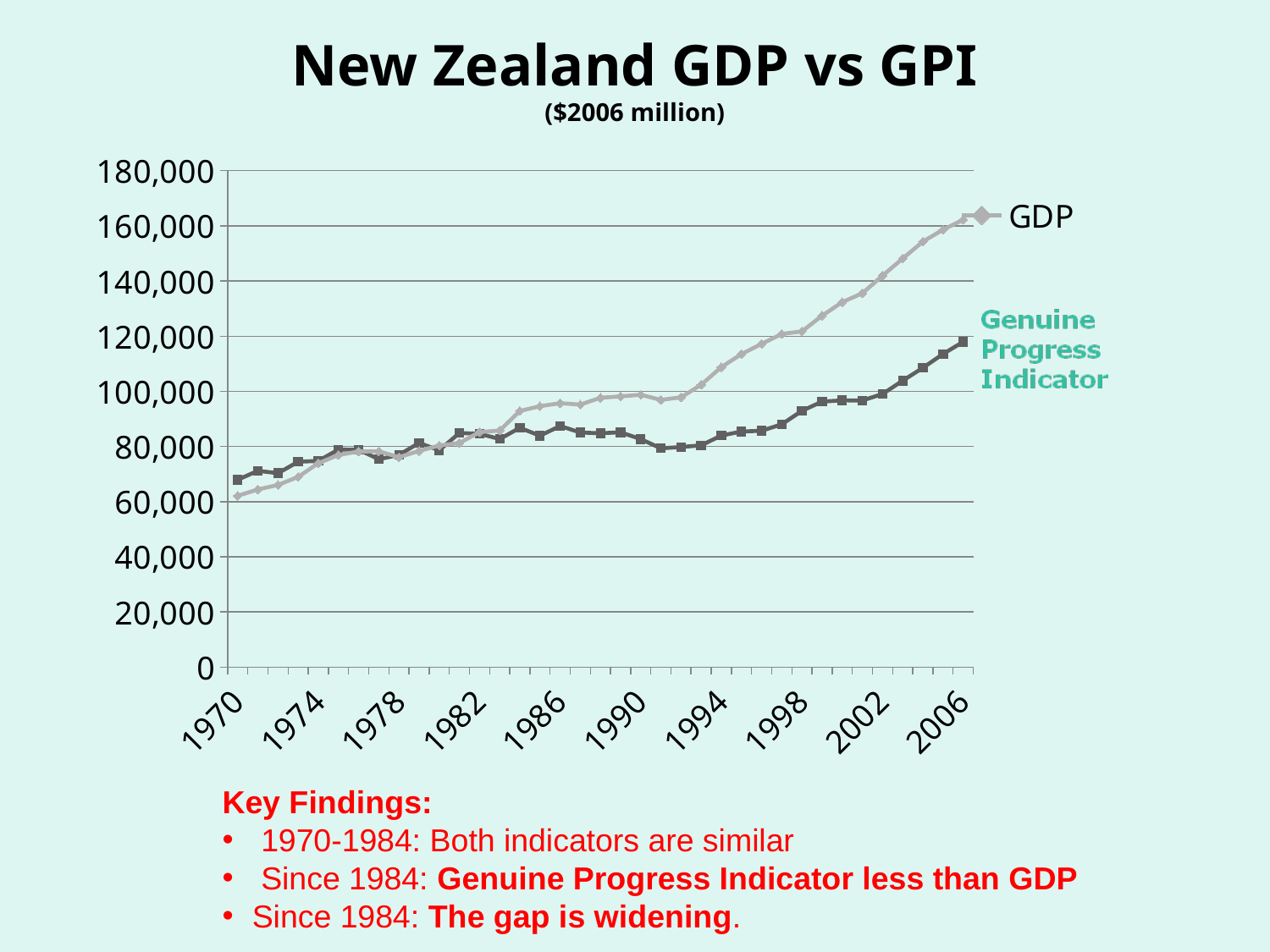
Is the Genuine Progress Indicator value for 2006 greater or less than 100,000? greater What unit is given under the chart title? $2006 million In 2006, which series has the higher value, GDP or Genuine Progress Indicator? GDP How many series are plotted on the chart? 2 Is the Genuine Progress Indicator value for 1994 greater or less than 100,000? less Is the GDP value for 2006 greater or less than 140,000? greater What is the title of the chart? New Zealand GDP vs GPI What kind of chart is shown on the slide? line chart Does the GDP series rise or fall overall from 1970 to 2006? rise In 1970, which series has the higher value, GDP or Genuine Progress Indicator? Genuine Progress Indicator